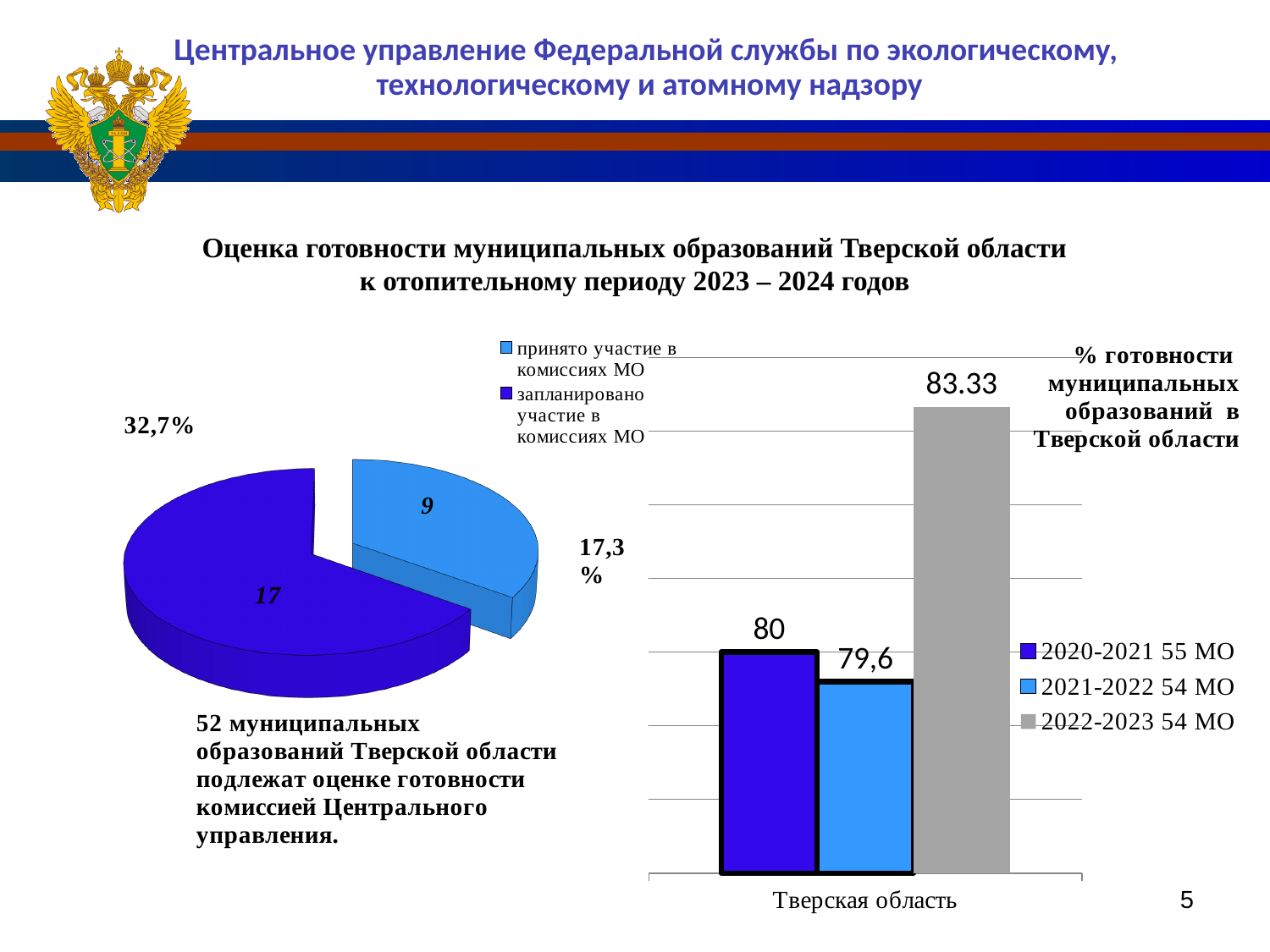
In the bar chart on the right, what is the value for the 2022-2023 54 МО series? 83.33 In the bar chart on the right, what is the value for the 2021-2022 54 МО series? 79,6 In the pie chart on the left, which slice is larger: 'принято участие в комиссиях МО' or 'запланировано участие в комиссиях МО'? запланировано участие в комиссиях МО In the bar chart on the right, which series has the highest value? 2022-2023 54 МО In the pie chart on the left, what is the value of the slice for 'принято участие в комиссиях МО'? 9 In the bar chart on the right, how many series does the legend list? 3 What kind of chart is the chart on the left of the slide? pie chart In the bar chart on the right, which series has the lowest value? 2021-2022 54 МО In the bar chart on the right, what is the value for the 2020-2021 55 МО series? 80 In the bar chart on the right, what is the category label on the x axis? Тверская область What kind of chart is the chart on the right of the slide? bar chart In the pie chart on the left, what is the value of the slice for 'запланировано участие в комиссиях МО'? 17